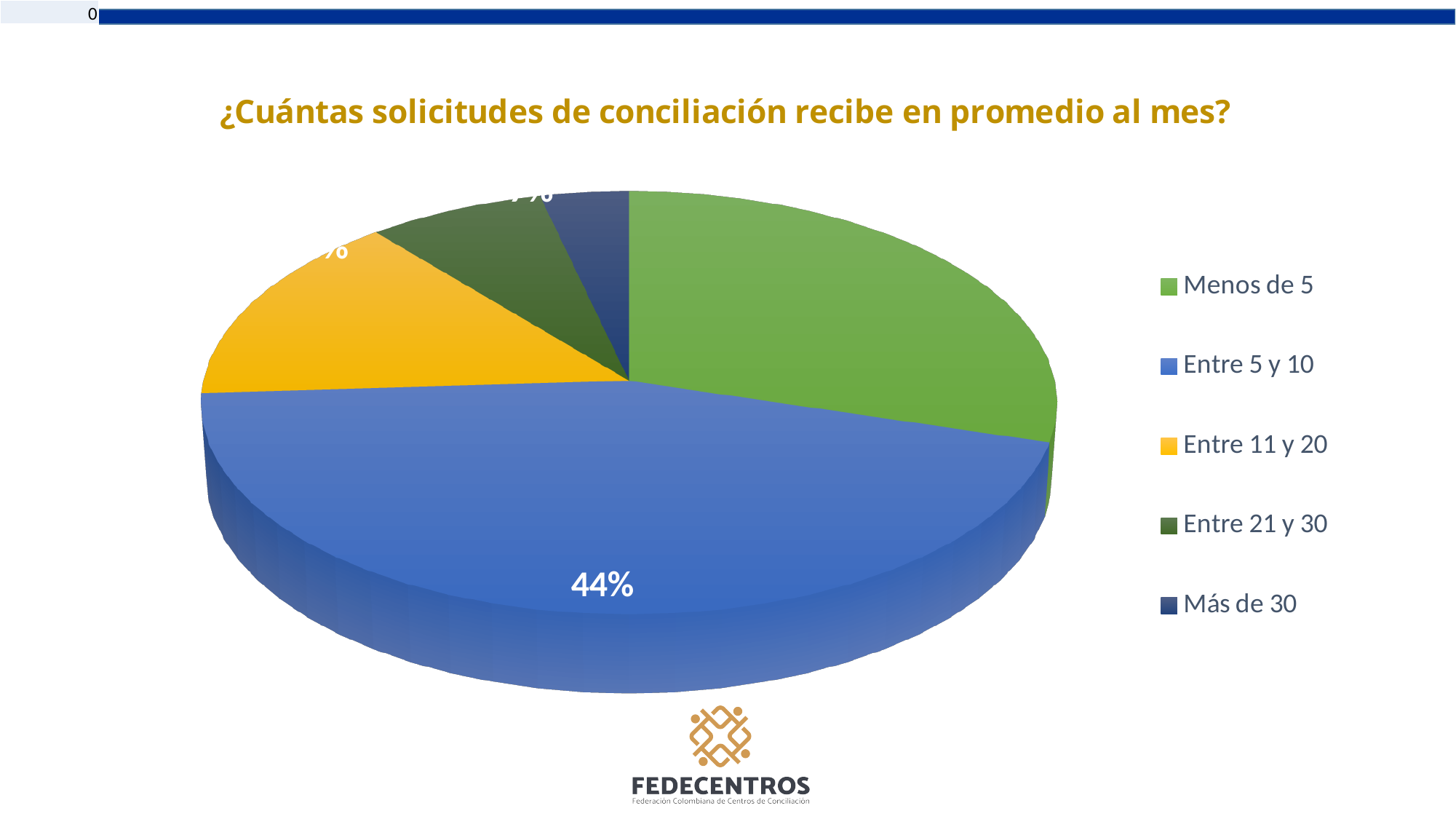
What colour is the 'Entre 11 y 20' slice? Yellow Which category is listed first in the legend? Menos de 5 Which slice is larger, 'Entre 21 y 30' or 'Entre 11 y 20'? Entre 11 y 20 What is the title of the chart? ¿Cuántas solicitudes de conciliación recibe en promedio al mes? What percentage is shown for the 'Entre 5 y 10' slice? 44% Which category has the smallest slice of the pie? Más de 30 Which slice is larger, 'Entre 5 y 10' or 'Menos de 5'? Entre 5 y 10 Which category has the largest slice of the pie? Entre 5 y 10 How many categories does the legend list? 5 Which slice is larger, 'Menos de 5' or 'Entre 11 y 20'? Menos de 5 What kind of chart is shown on the slide? Pie chart